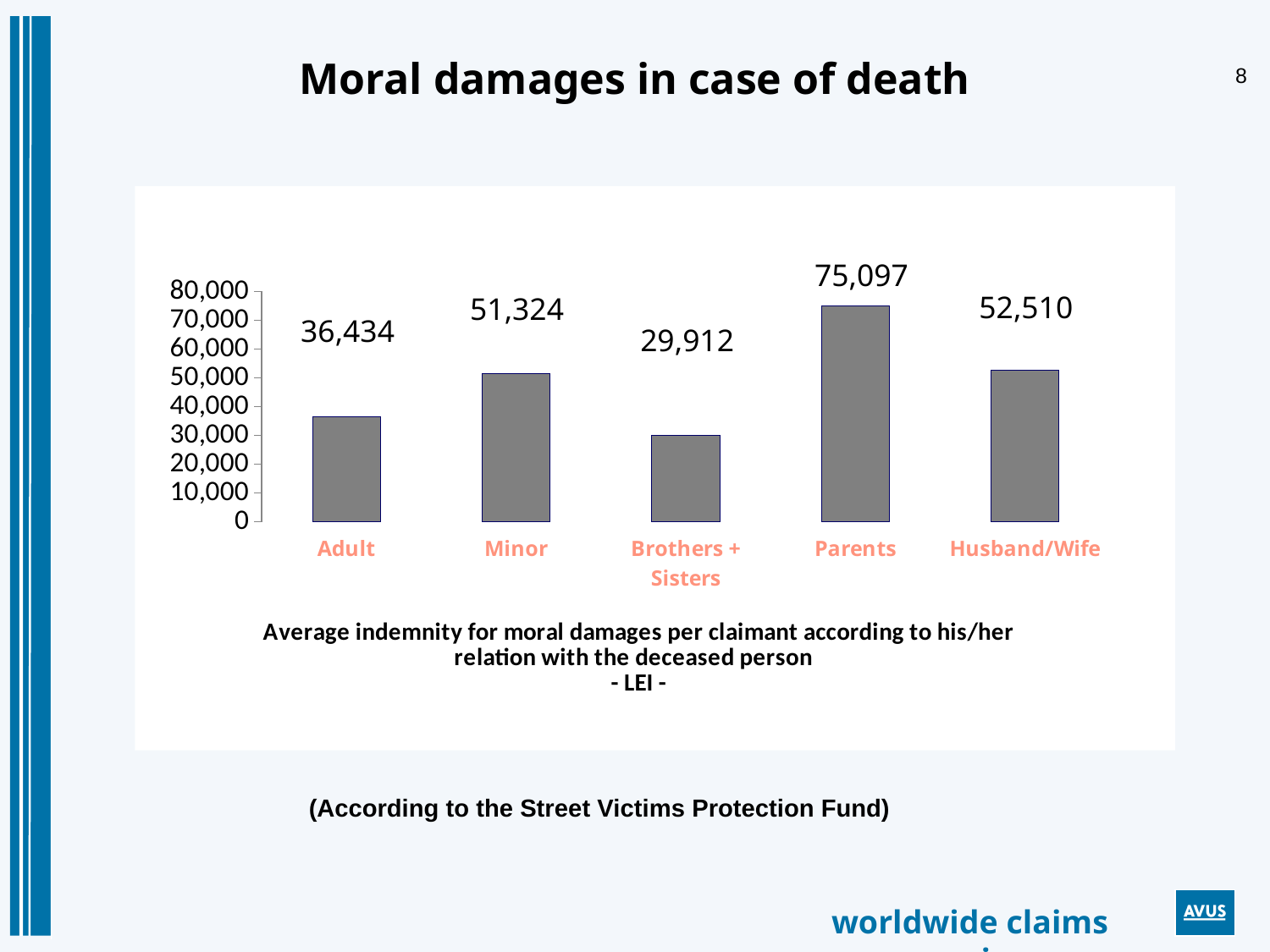
What is the difference between the values for Parents and Adult? 38,663 What is the value shown for Husband/Wife? 52,510 How many categories are shown on the chart? 5 What is the difference between the values for Husband/Wife and Minor? 1,186 Which category has the highest average indemnity? Parents Which category has the lowest average indemnity? Brothers + Sisters Which is larger, the value for Minor or the value for Adult? Minor What is the value shown for Parents? 75,097 What is the average indemnity for moral damages for Adult? 36,434 What is the value shown for Brothers + Sisters? 29,912 Is the value for Parents greater or less than 70,000? greater What kind of chart is shown on the slide? Bar chart